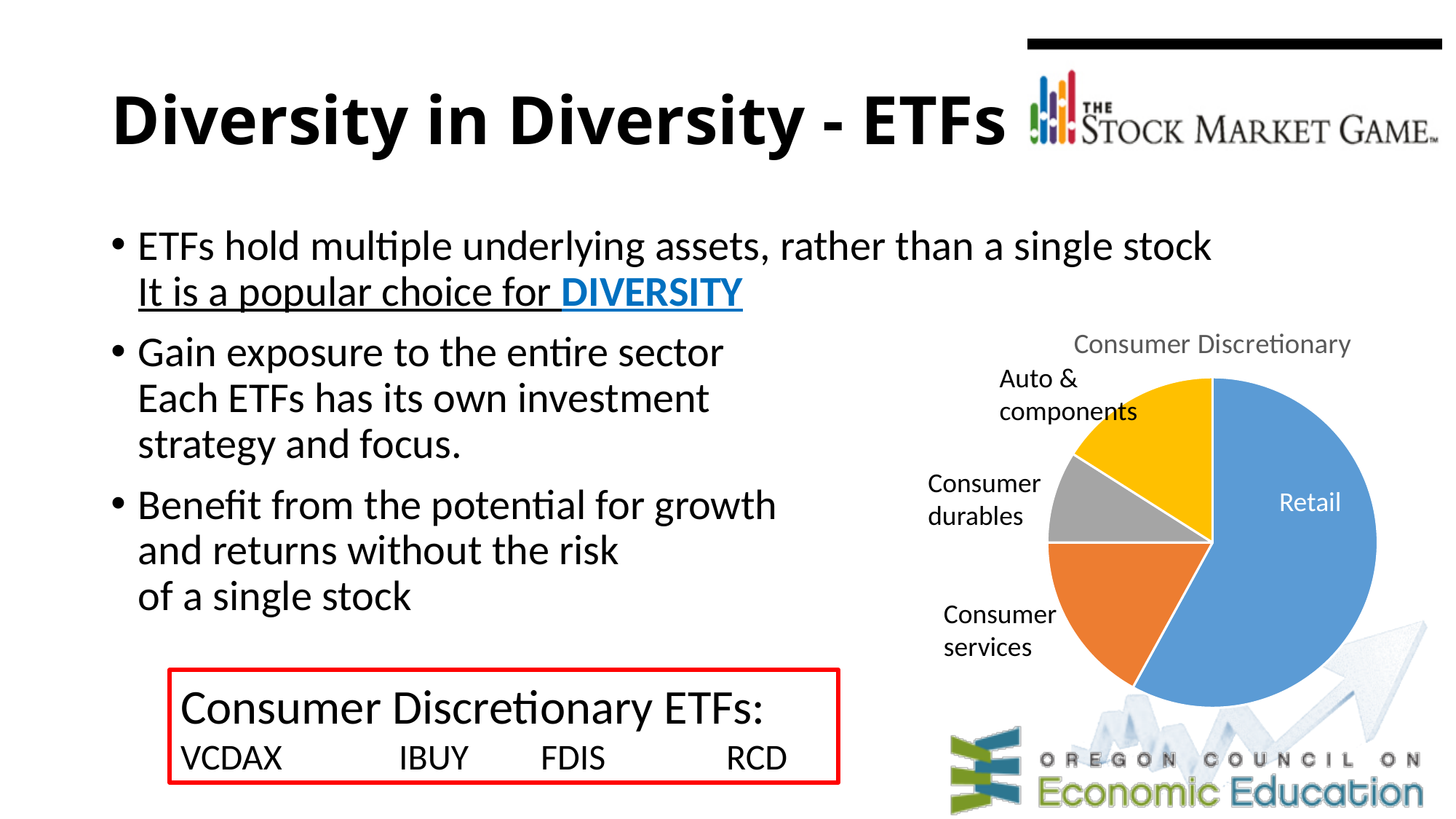
What kind of chart is shown on the slide? pie chart In the Consumer Discretionary pie chart, which slice is larger: Retail or Consumer services? Retail Which category has the smallest slice in the Consumer Discretionary pie chart? Consumer durables How many slices does the Consumer Discretionary pie chart have? 4 In the Consumer Discretionary pie chart, which slice is larger: Auto & components or Consumer durables? Auto & components What is the title of the pie chart? Consumer Discretionary What colour is the Retail slice in the Consumer Discretionary pie chart? blue In the Consumer Discretionary pie chart, which slice is larger: Consumer services or Consumer durables? Consumer services Which category has the largest slice in the Consumer Discretionary pie chart? Retail